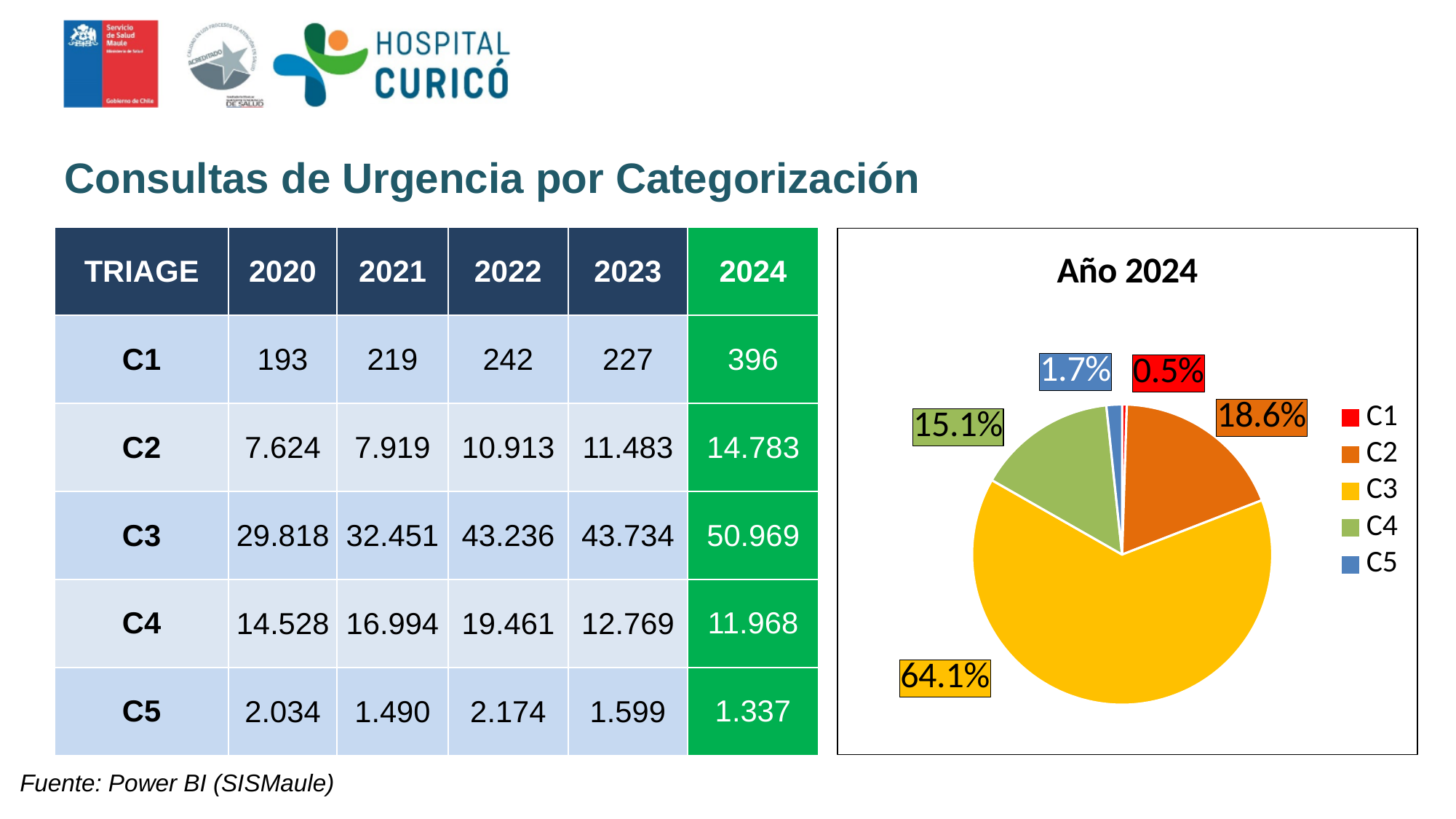
What percentage is shown for C4 in the pie chart? 15.1% What kind of chart is shown on the slide? pie chart What is the title of the pie chart? Año 2024 Which category has the largest slice of the pie? C3 What percentage is shown for C1 in the pie chart? 0.5% What percentage is shown for C2 in the pie chart? 18.6% What is the difference in percentage points between C2 and C4 in the pie chart? 3.5 Which has a larger share of the pie, C4 or C5? C4 What share of the pie does C3 represent? 64.1% What percentage is shown for C5 in the pie chart? 1.7% How many categories does the pie chart legend list? 5 Which category has the smallest slice of the pie? C1